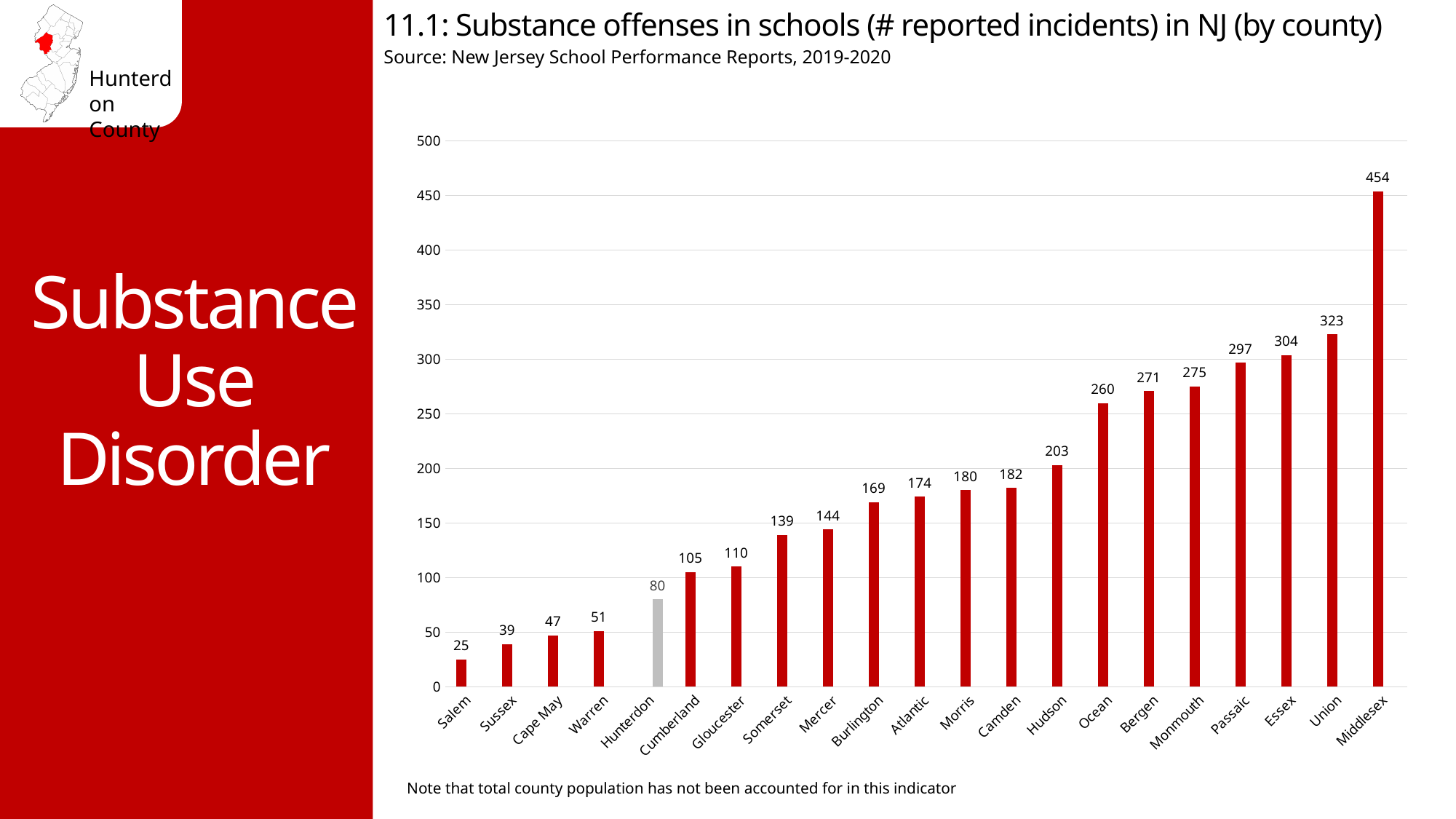
How many more incidents does Hunterdon have than Warren? 29 How many reported incidents are shown for Mercer County? 144 Is the value for Hudson greater or less than 200? greater What is the number of reported substance offense incidents in schools for Hunterdon County? 80 Which county has the lowest number of reported incidents? Salem What is the value shown for Middlesex County? 454 Which county has the highest number of reported incidents? Middlesex Which county has a larger value, Bergen or Ocean? Bergen What is the difference between the values for Middlesex and Union? 131 How many counties are shown on the chart? 21 Which county's bar is coloured grey instead of red? Hunterdon What kind of chart is shown on the slide? Bar chart